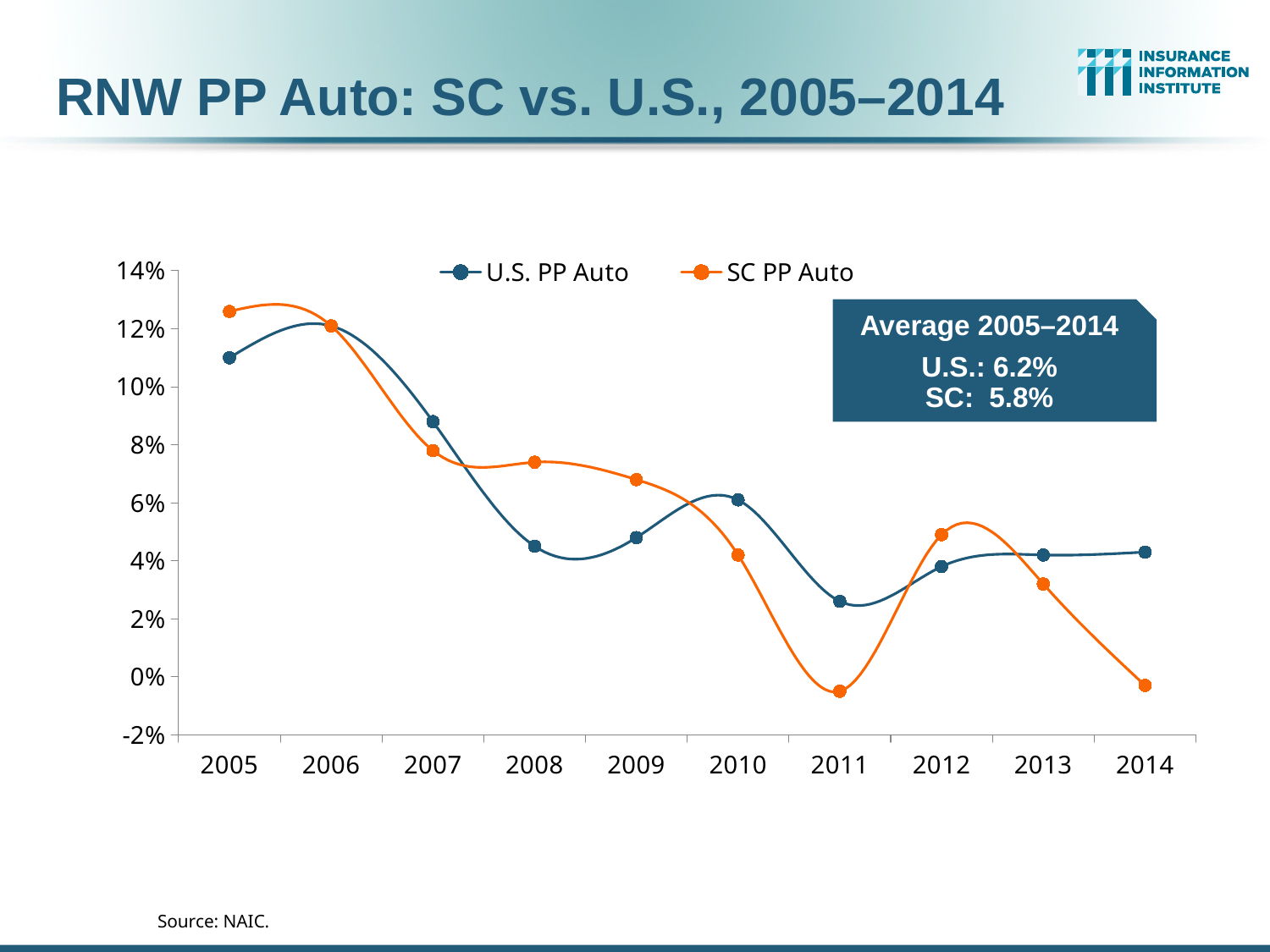
Do the values for SC PP Auto generally rise or fall from 2005 to 2014? Fall Is the value for U.S. PP Auto in 2005 greater or less than 10%? greater In 2009, which series has the higher value, U.S. PP Auto or SC PP Auto? SC PP Auto How many years are plotted along the x axis? 10 According to the text box on the chart, what is the U.S. average for 2005–2014? 6.2% What kind of chart is shown on the slide? Line chart Is the value for SC PP Auto in 2008 greater or less than 6%? greater How many series does the legend list? 2 In 2010, which series has the higher value, U.S. PP Auto or SC PP Auto? U.S. PP Auto In which year is the U.S. PP Auto value lowest? 2011 Is the value for SC PP Auto in 2011 greater or less than 0%? less